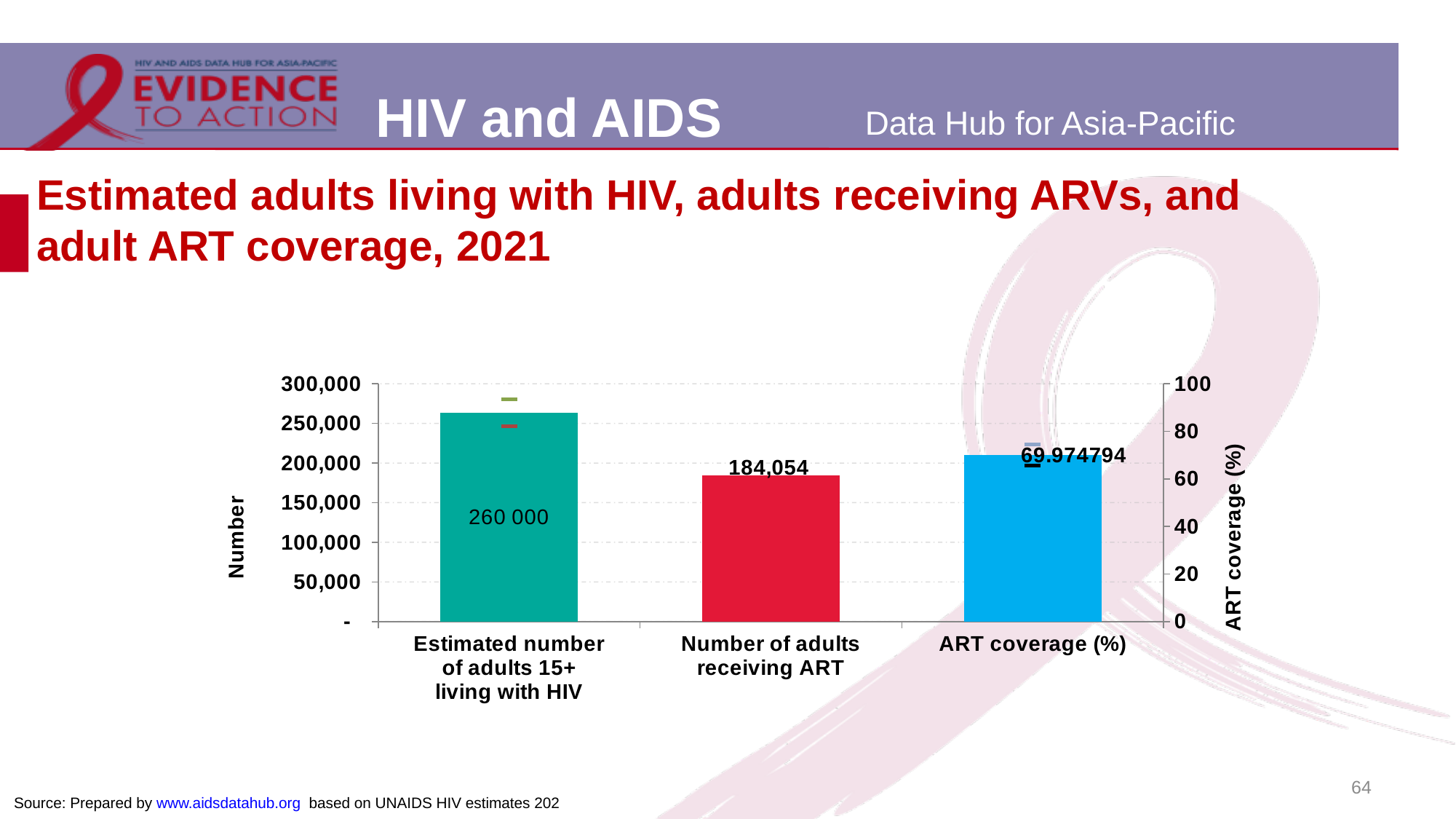
Which is larger: the estimated number of adults 15+ living with HIV or the number of adults receiving ART? Estimated number of adults 15+ living with HIV How many bars are plotted on the chart? 3 What type of chart is shown on the slide? Bar chart What ART coverage (%) value is labelled on the chart? 69.974794 What is the title of the right-hand vertical axis? ART coverage (%) Is the ART coverage (%) value greater or less than 60 on the right-hand axis? greater Which category has the tallest bar on the chart? Estimated number of adults 15+ living with HIV Is the ART coverage (%) value greater or less than 80 on the right-hand axis? less What is the title of the left-hand vertical axis? Number What is the number of adults receiving ART shown on the chart? 184,054 What is the estimated number of adults 15+ living with HIV shown on the chart? 260 000